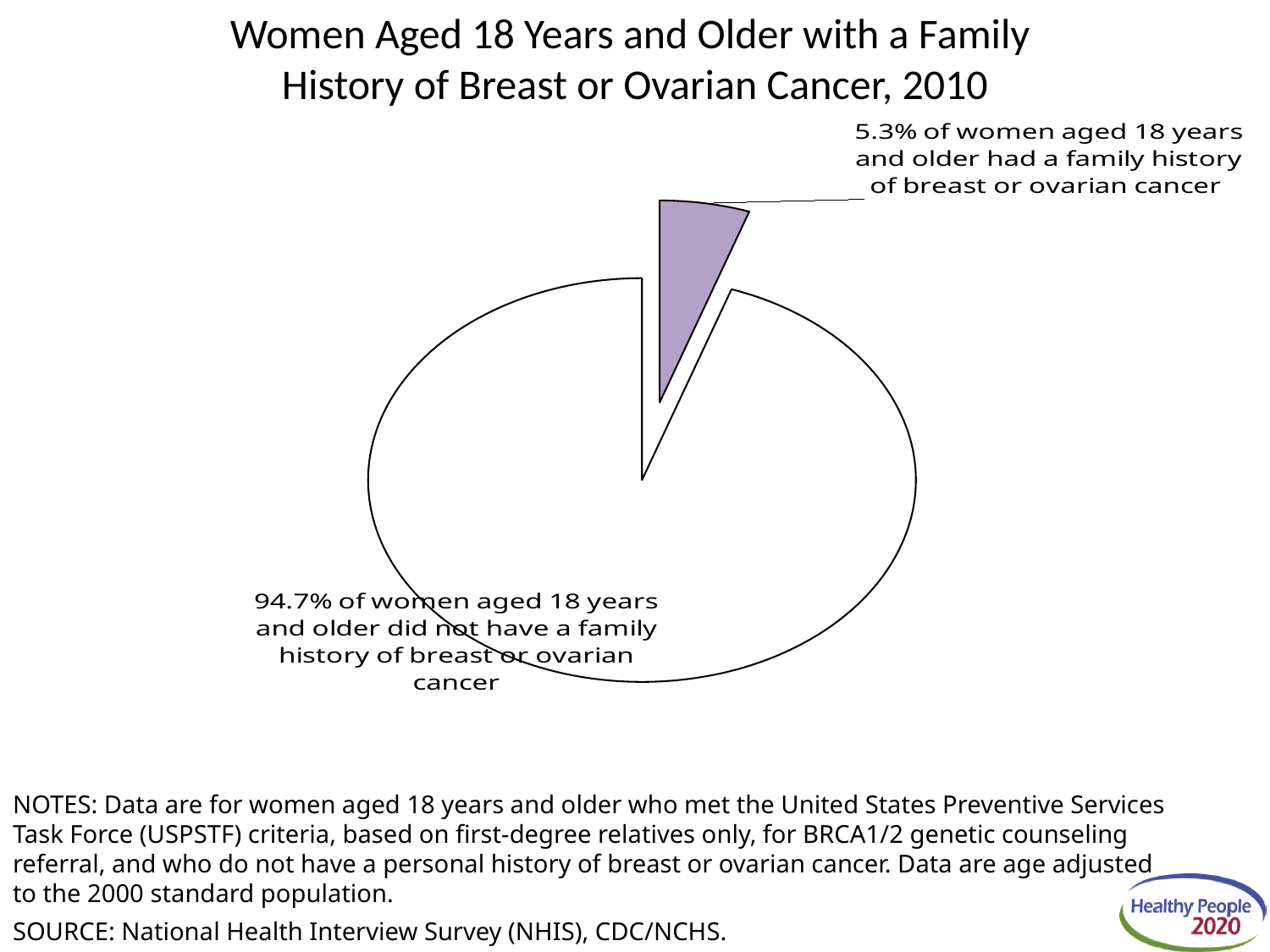
Which group makes up the largest share of the pie? Women who did not have a family history of breast or ovarian cancer Is the share of women who had a family history of breast or ovarian cancer greater or less than 10%? less What colour is the slice representing women who had a family history of breast or ovarian cancer? Purple What is the title of the chart? Women Aged 18 Years and Older with a Family History of Breast or Ovarian Cancer, 2010 What percentage of women aged 18 years and older did not have a family history of breast or ovarian cancer? 94.7% How many slices does the pie chart have? 2 Which group makes up the smallest share of the pie? Women who had a family history of breast or ovarian cancer What percentage of women aged 18 years and older had a family history of breast or ovarian cancer? 5.3% What is the difference in percentage points between the share of women without a family history and the share with a family history? 89.4 What kind of chart is shown on the slide? Pie chart What share of the pie does the slice for women with a family history of breast or ovarian cancer represent? 5.3% Which slice is larger: women with a family history of breast or ovarian cancer, or women without? Women without a family history